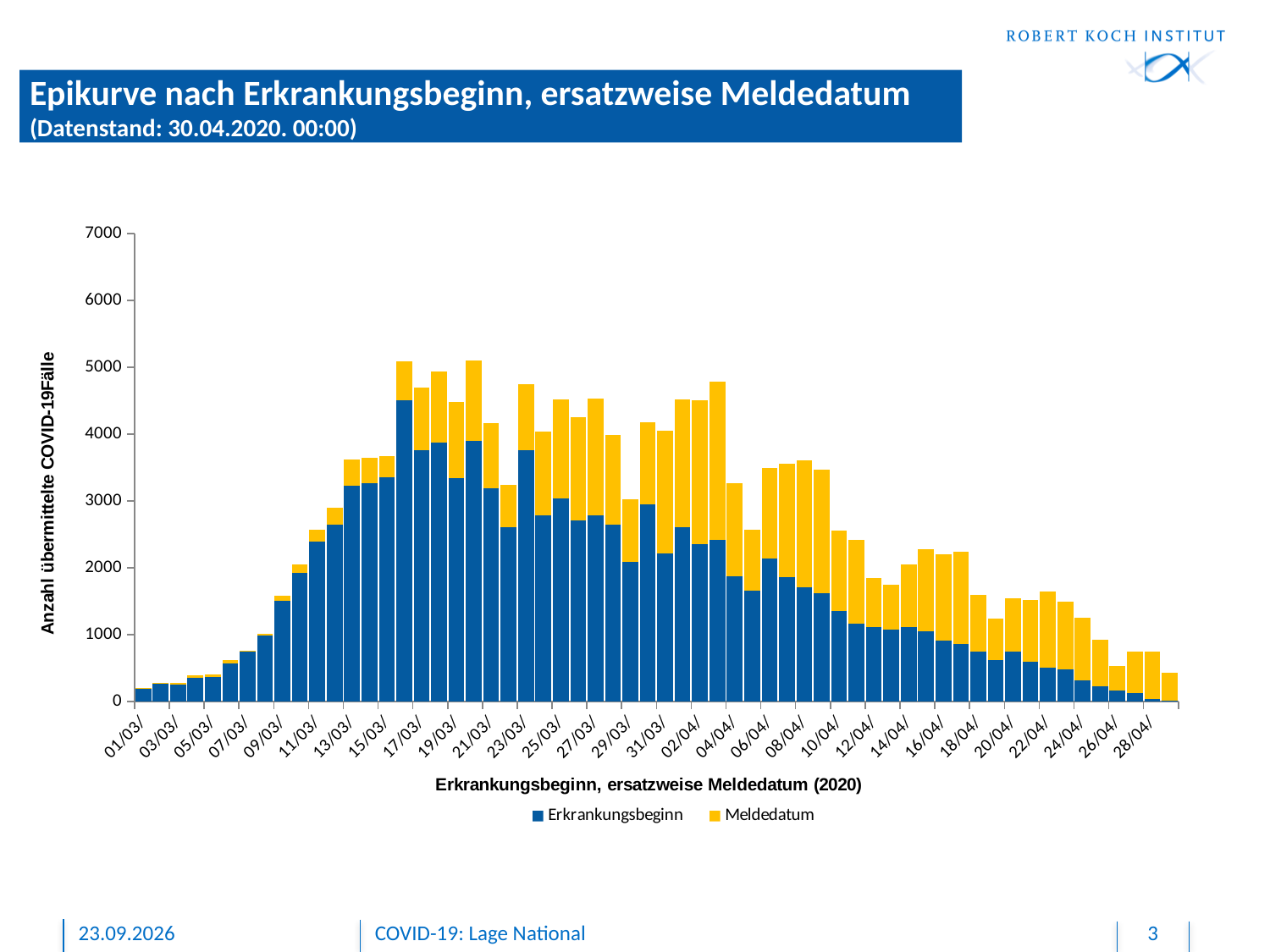
What kind of chart is shown on the slide? bar chart Do the total bar heights rise or fall from 17/04 to 28/04? fall What are the two series named in the legend? Erkrankungsbeginn and Meldedatum Is the total bar height for 01/03 greater or less than 1000? less Do the total bar heights rise or fall from 01/03 to 15/03? rise Is the total bar height for 13/03 greater or less than 3000? greater Which date has the larger total bar, 17/03 or 01/03? 17/03 Is the tallest bar in the chart greater or less than 6000? less What is the title of the y axis? Anzahl übermittelte COVID-19Fälle How many series does the legend list? 2